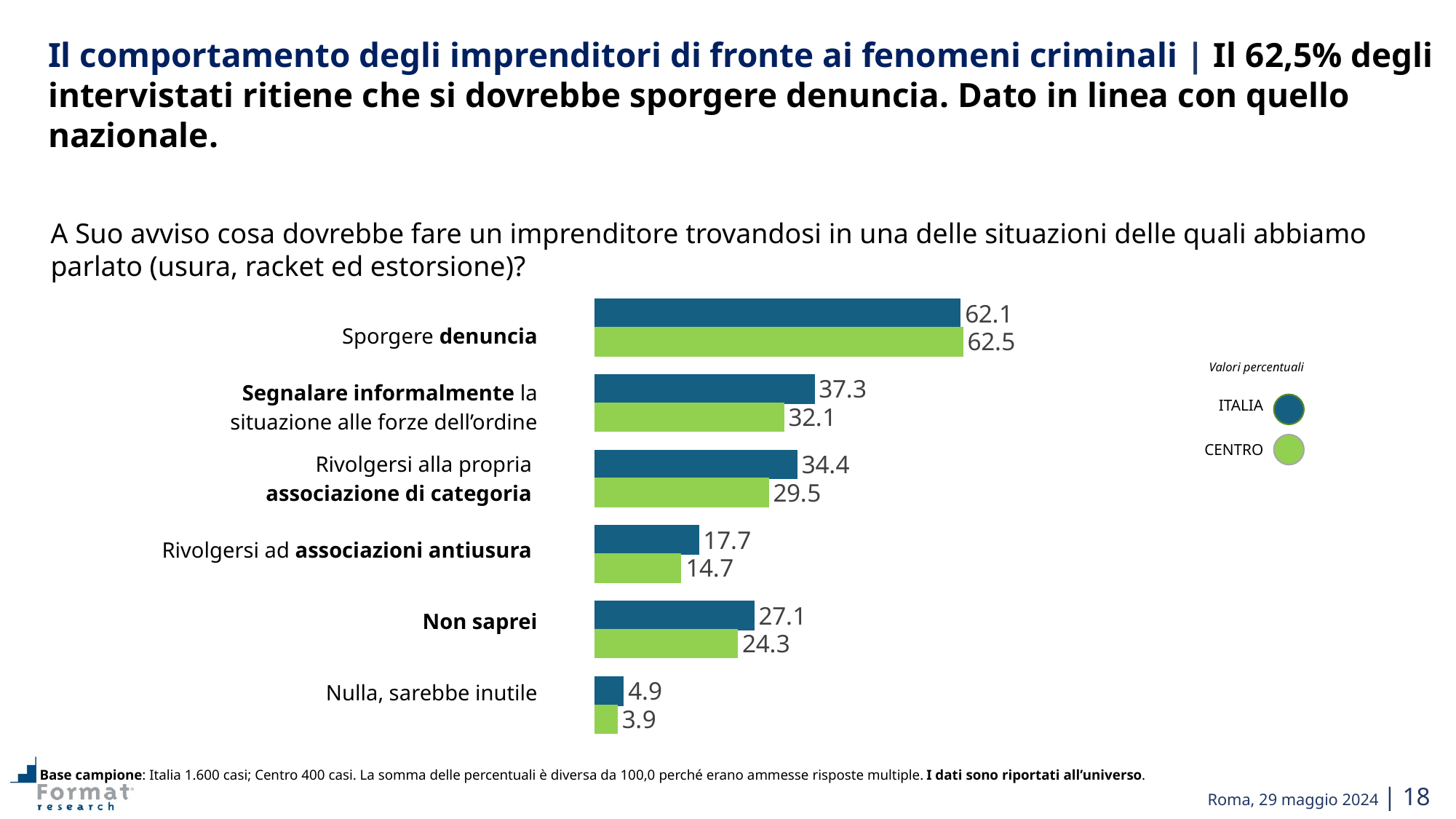
How many series does the legend list? 2 What is the CENTRO value for "Segnalare informalmente la situazione alle forze dell'ordine"? 32.1 How many categories are shown in the chart? 6 What kind of chart is shown on the slide? Bar chart Which is larger for "Rivolgersi alla propria associazione di categoria": the ITALIA value or the CENTRO value? ITALIA What is the difference between the ITALIA and CENTRO values for "Non saprei"? 2.8 Which category has the highest ITALIA value? Sporgere denuncia Which category has the lowest CENTRO value? Nulla, sarebbe inutile Which colour represents the CENTRO series in the chart? Green What is the ITALIA value for "Rivolgersi ad associazioni antiusura"? 17.7 What is the CENTRO value for "Sporgere denuncia"? 62.5 What is the ITALIA value for "Sporgere denuncia"? 62.1